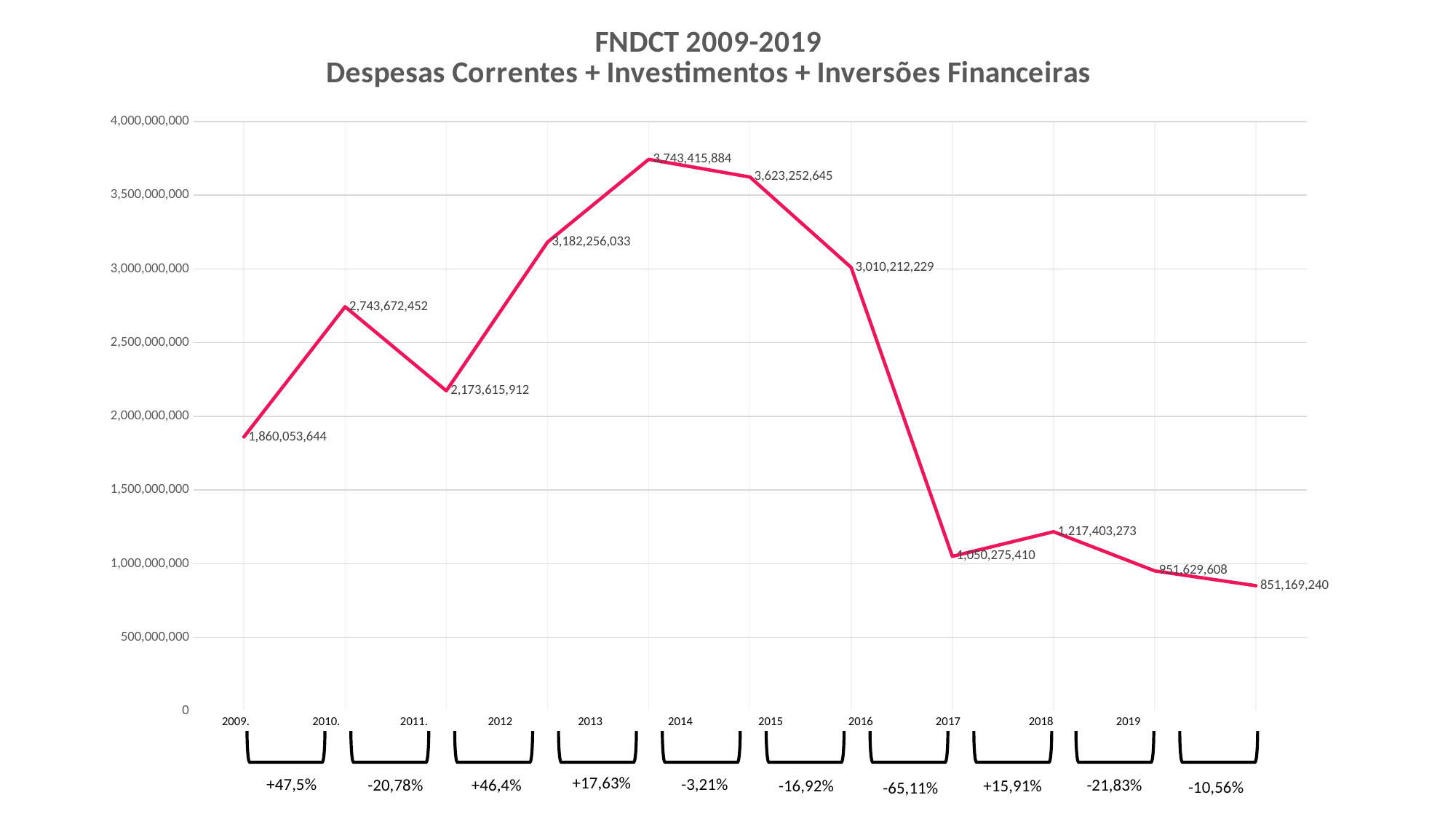
Do the values rise or fall from 2015 to 2019? fall What percentage change is shown between 2015 and 2016 below the chart? -65,11% What is the difference between the values for 2013 and 2014? 120,163,239 What type of chart is shown on the slide? line chart Which year has the lowest value? 2019 Is the value for 2016 greater or less than 1,500,000,000? less Which year has the highest value? 2013 What is the value for 2009? 1,860,053,644 Which is larger, the value for 2010 or the value for 2011? 2010 How many data points are plotted on the line? 11 What is the value for 2013? 3,743,415,884 What is the value for 2019? 851,169,240